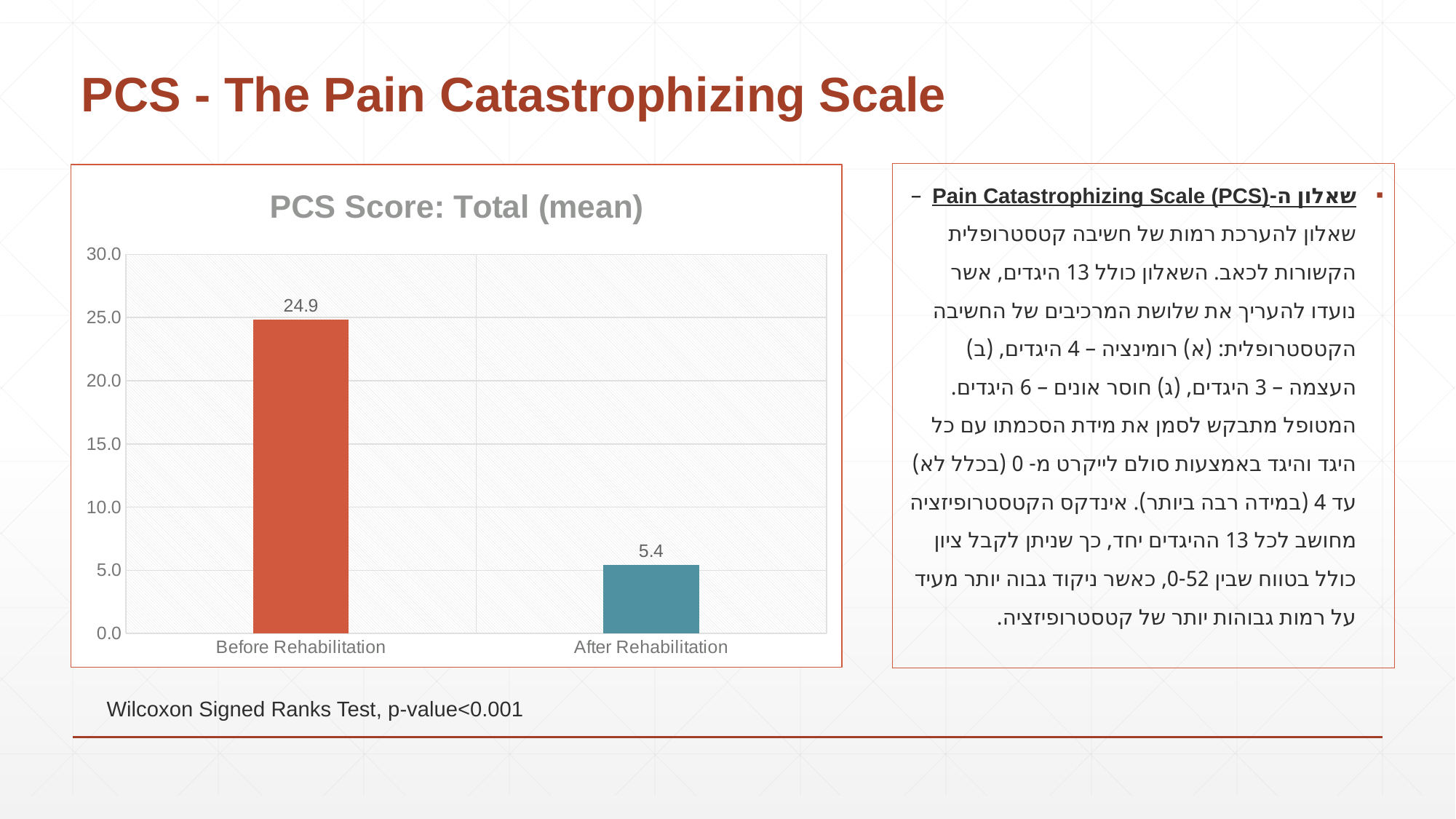
Is the value for After Rehabilitation greater or less than 10.0? less What kind of chart is shown on the slide? Bar chart Which is larger, the PCS Score Before Rehabilitation or After Rehabilitation? Before Rehabilitation What is the PCS Score value for Before Rehabilitation? 24.9 Which category has the lowest PCS Score? After Rehabilitation Do the values rise or fall from Before Rehabilitation to After Rehabilitation? Fall What is the PCS Score value for After Rehabilitation? 5.4 How many categories are shown on the x axis of the chart? 2 Which category has the highest PCS Score? Before Rehabilitation What is the difference between the Before Rehabilitation and After Rehabilitation PCS Scores? 19.5 What is the title of the chart? PCS Score: Total (mean) Is the value for Before Rehabilitation greater or less than 20.0? greater